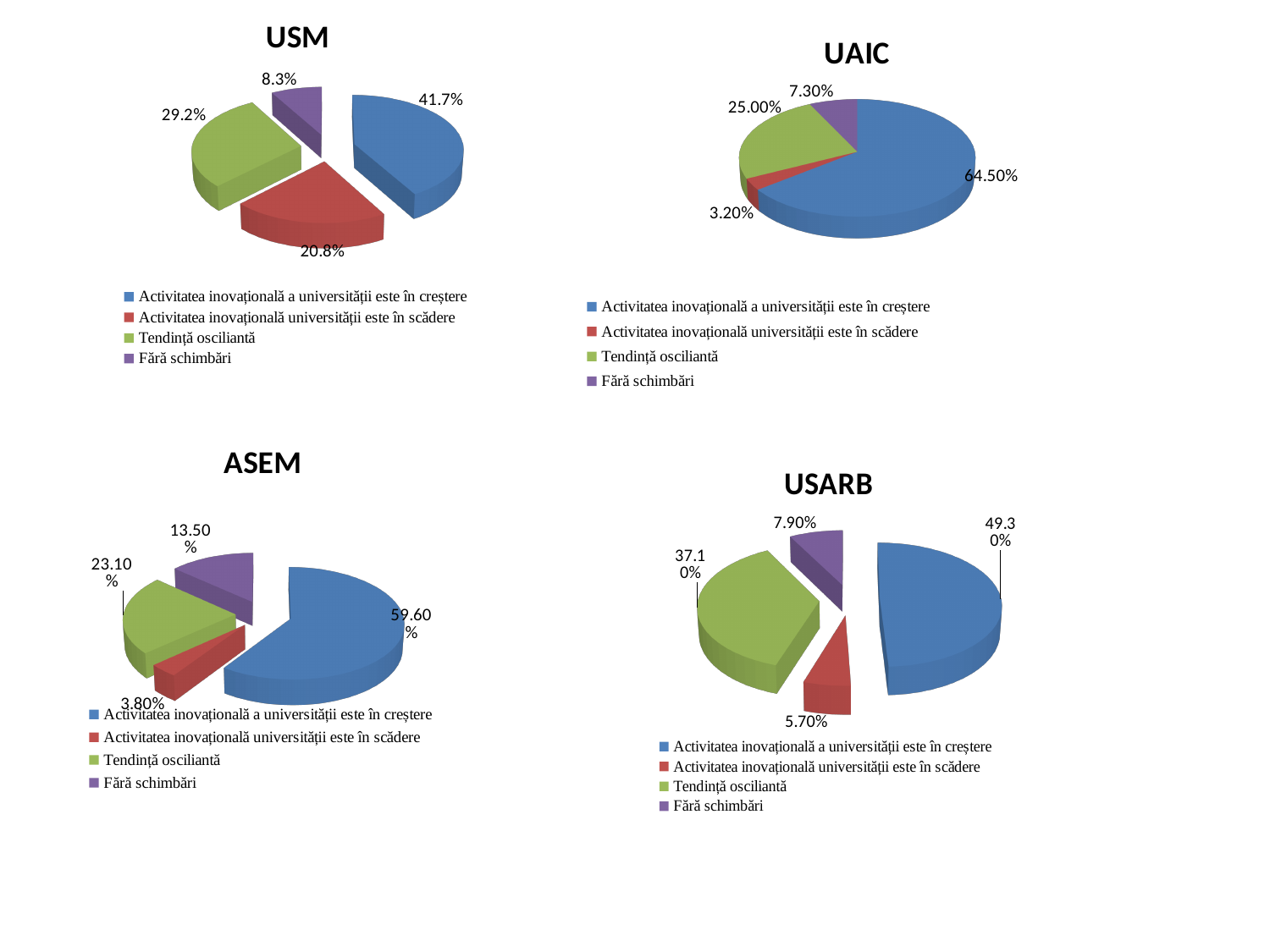
In the USARB chart, what percentage is shown for "Tendință osciliantă"? 37.10% What type of chart is the ASEM chart? Pie chart In the USARB chart, what is the difference between the shares for "Activitatea inovațională a universității este în creștere" and "Tendință osciliantă"? 12.20% In the UAIC chart, which category has the smallest share? Activitatea inovațională universității este în scădere How many charts are shown on the slide? 4 In the USM chart, what percentage is shown for "Activitatea inovațională a universității este în creștere"? 41.7% In the USM chart, what percentage is shown for "Fără schimbări"? 8.3% In the ASEM chart, what percentage is shown for "Fără schimbări"? 13.50% In the UAIC chart, what percentage is shown for "Tendință osciliantă"? 25.00% In the USM chart, which is larger: the share for "Tendință osciliantă" or the share for "Activitatea inovațională universității este în scădere"? Tendință osciliantă How many slices does the UAIC pie chart have? 4 In the ASEM chart, which category has the largest share? Activitatea inovațională a universității este în creștere